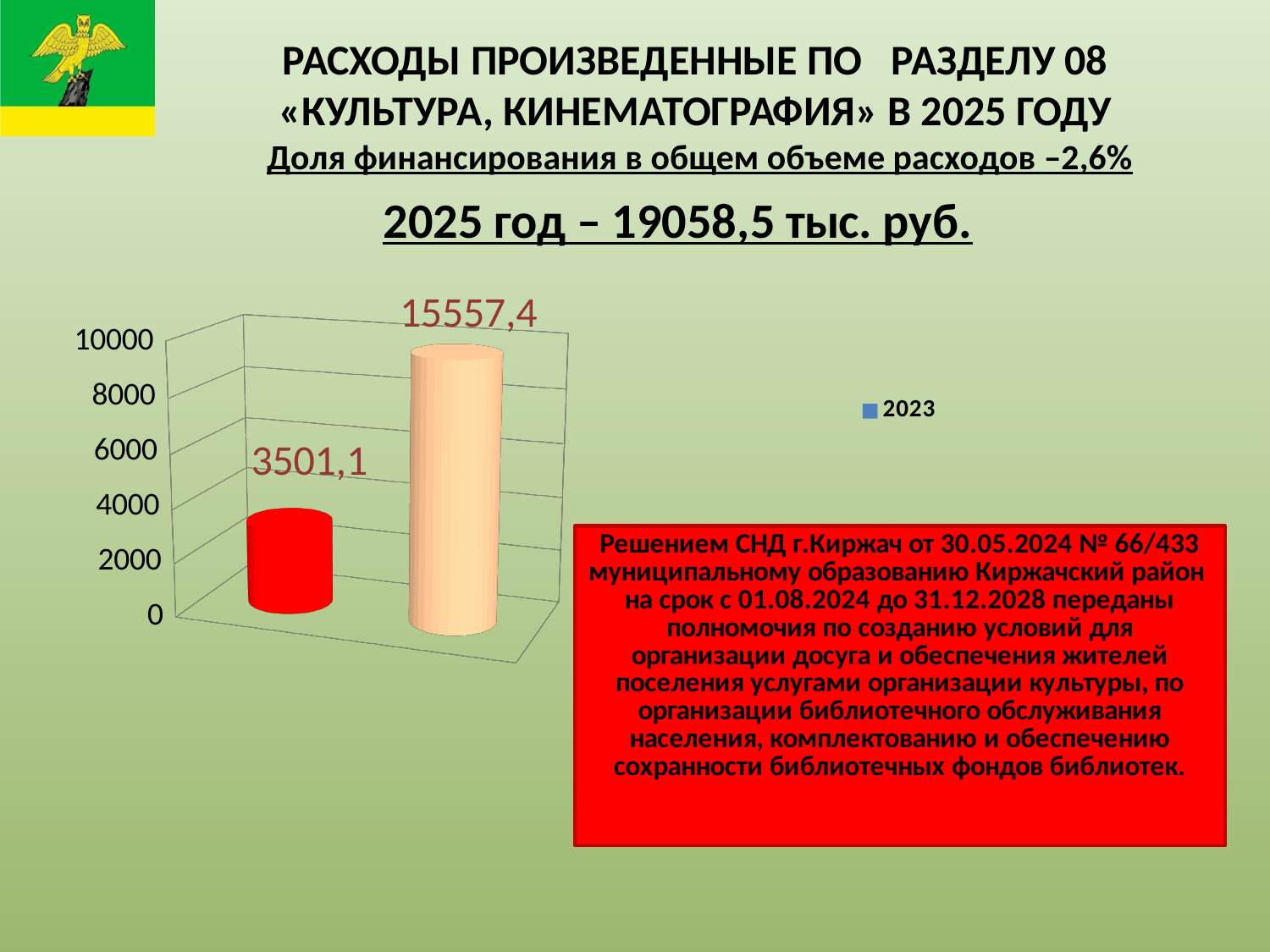
What type of chart is shown on the slide? bar chart What is the highest value labelled in the chart? 15557,4 Is the value of the red bar greater or less than 4000? less What is the value shown on the red bar? 3501,1 Which bar is larger, the red bar or the peach-coloured bar? the peach-coloured bar What is the value shown on the peach-coloured (right) bar? 15557,4 How many series does the chart legend list? 1 What entry is shown in the chart legend? 2023 What is the lowest value labelled in the chart? 3501,1 How many bars are plotted in the chart? 2 What is the sum of the two bar values shown in the chart? 19058,5 What is the difference between the right bar (15557,4) and the red bar (3501,1)? 12056,3